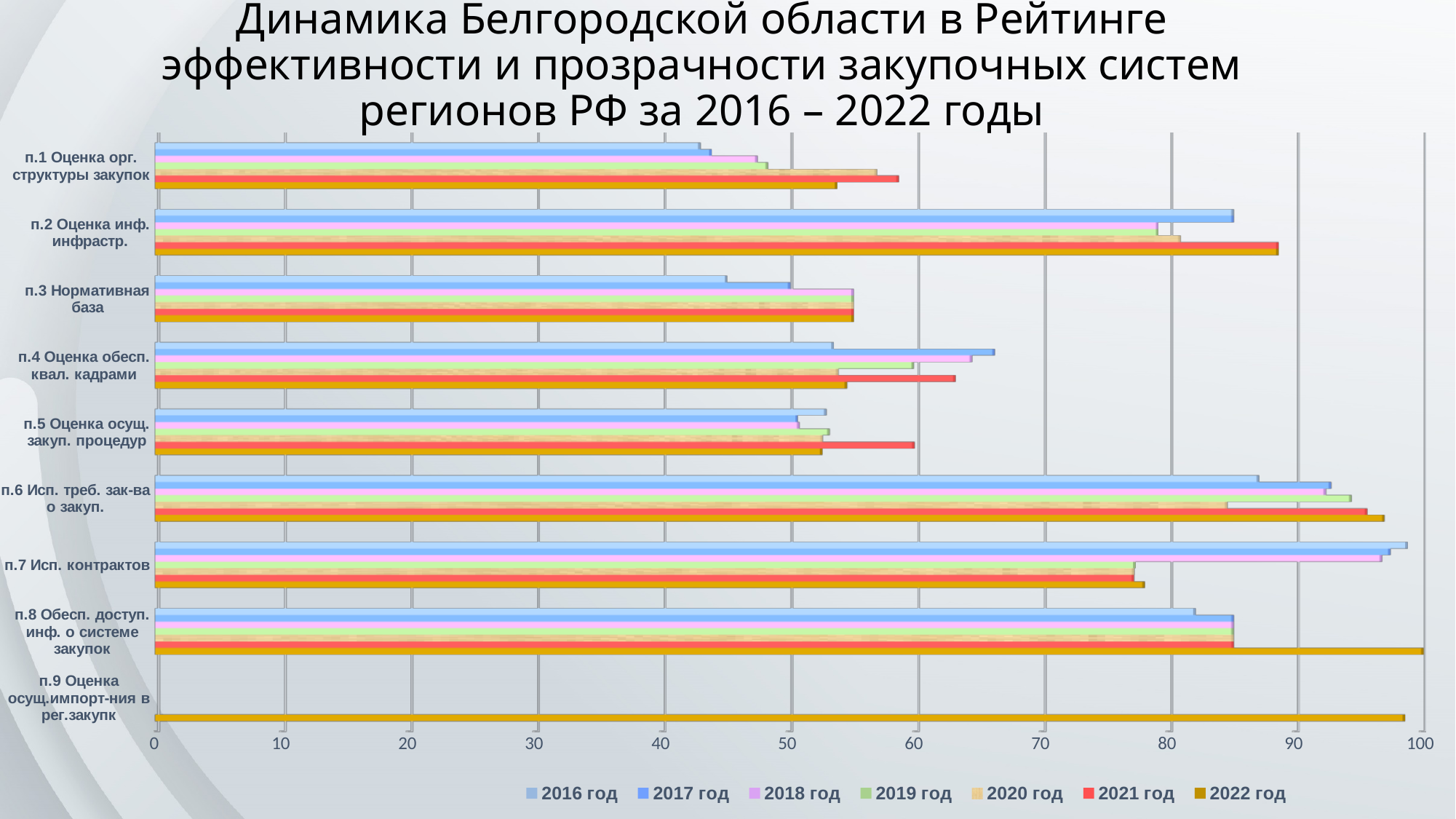
In category п.5 Оценка осущ. закуп. процедур, which year has the highest value? 2021 год Is the value for 2016 год in category п.1 Оценка орг. структуры закупок greater or less than 50? less Is the value for 2022 год in category п.9 Оценка осущ.импорт-ния в рег.закупк greater or less than 90? greater How many categories (п.1 to п.9) are plotted on the chart? 9 Which is larger in category п.7 Исп. контрактов: the value for 2016 год or the value for 2022 год? 2016 год How many series does the legend list? 7 Is the value for 2021 год in category п.2 Оценка инф. инфрастр. greater or less than 80? greater What kind of chart is shown on the slide? bar chart Which series is shown in the dark gold/orange colour in the legend? 2022 год In category п.8 Обесп. доступ. инф. о системе закупок, which year has the highest value? 2022 год Which is larger for 2021 год: the value for п.2 Оценка инф. инфрастр. or the value for п.1 Оценка орг. структуры закупок? п.2 Оценка инф. инфрастр.